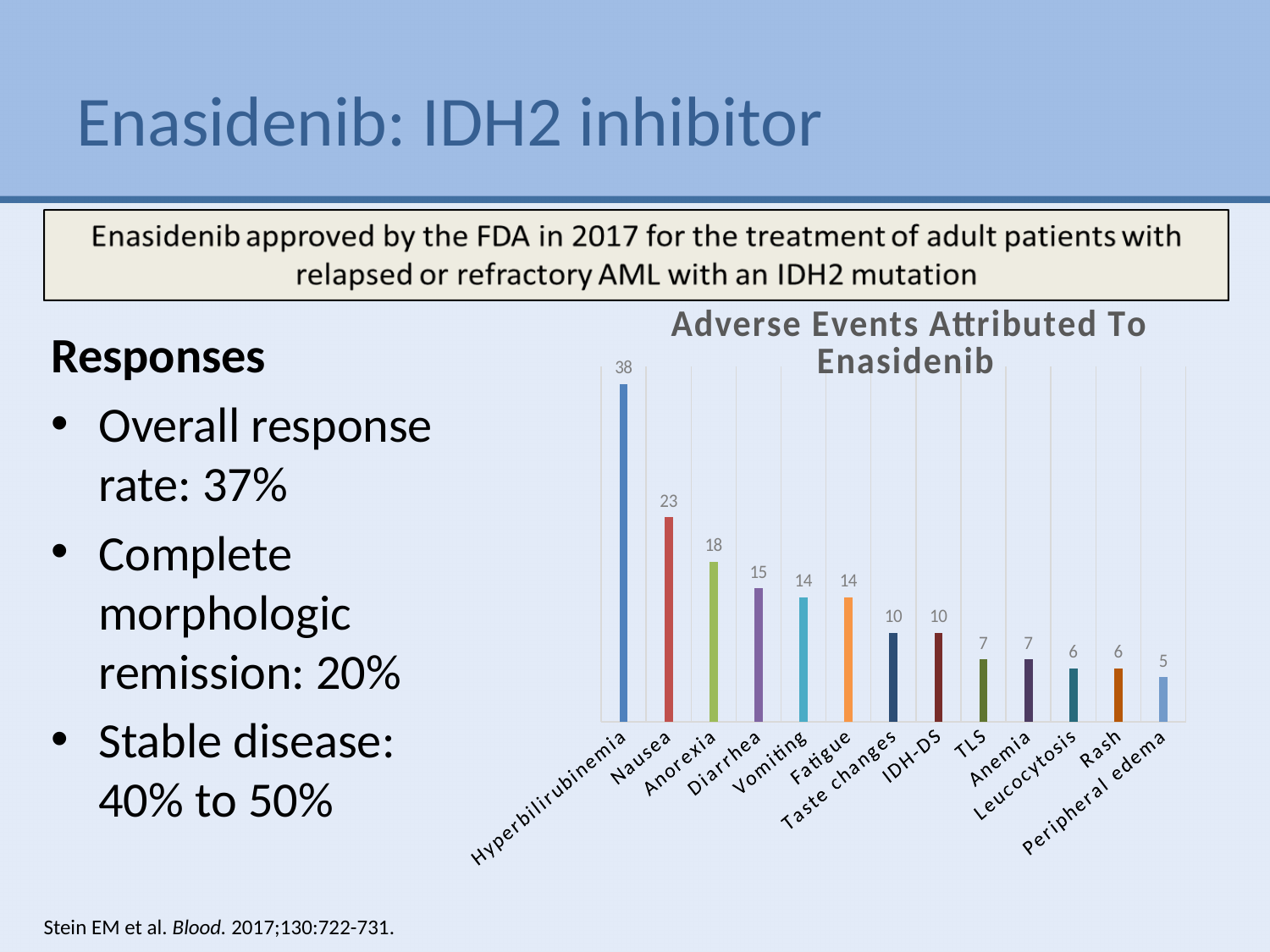
What is the value for Hyperbilirubinemia in the Adverse Events Attributed To Enasidenib chart? 38 Which adverse event has the lowest value in the chart? Peripheral edema What is the value for Peripheral edema in the Adverse Events Attributed To Enasidenib chart? 5 How many adverse event categories are shown in the chart? 13 Which has a larger value, Nausea or Anorexia? Nausea Which adverse event has the highest value in the chart? Hyperbilirubinemia What is the title of the chart on the slide? Adverse Events Attributed To Enasidenib What is the value for Nausea in the Adverse Events Attributed To Enasidenib chart? 23 What is the difference between the values for Anorexia and Diarrhea? 3 What kind of chart is used to show the adverse events attributed to enasidenib? Bar chart What is the value for Taste changes in the Adverse Events Attributed To Enasidenib chart? 10 What is the difference between the values for Hyperbilirubinemia and Nausea? 15